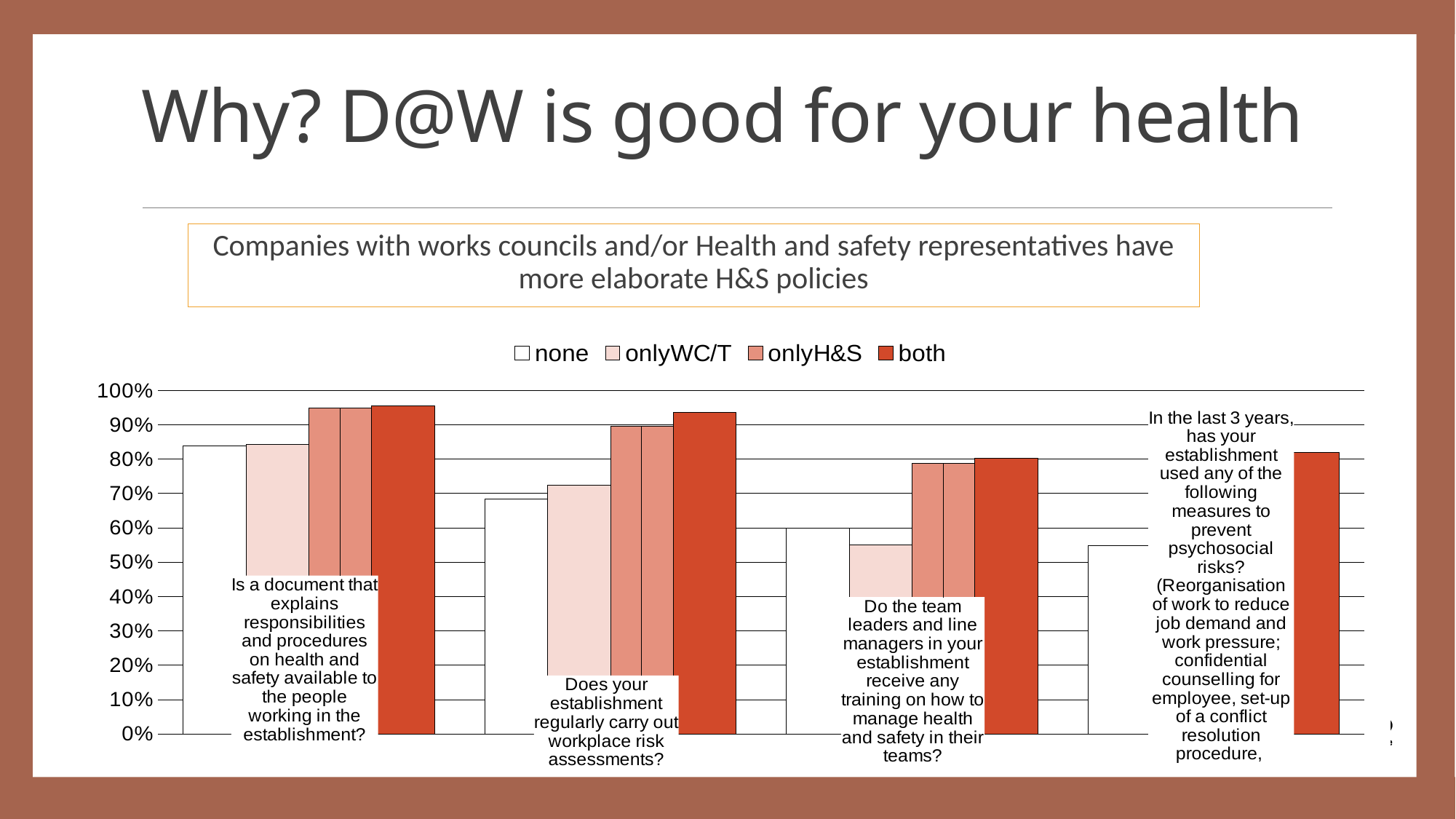
On the question about regular workplace risk assessments, which is larger: 'onlyWC/T' or 'onlyH&S'? onlyH&S What kind of chart is shown on the slide? Bar chart Is the value for 'none' on the question about regular workplace risk assessments greater or less than 60%? greater For which survey question is the 'both' value highest? Is a document that explains responsibilities and procedures on health and safety available to the people working in the establishment? Is the value for 'none' on the question about a document explaining H&S responsibilities greater or less than 80%? greater Does the 'none' series rise or fall across the survey questions from left to right? fall For which survey question is the 'none' value lowest? In the last 3 years, has your establishment used any of the following measures to prevent psychosocial risks? On the question about team leaders receiving H&S training, which is larger: 'none' or 'onlyWC/T'? none Is the value for 'onlyWC/T' on the question about team leaders receiving H&S training greater or less than 60%? less How many series does the legend list? 4 How many survey questions (categories) are plotted along the x axis? 4